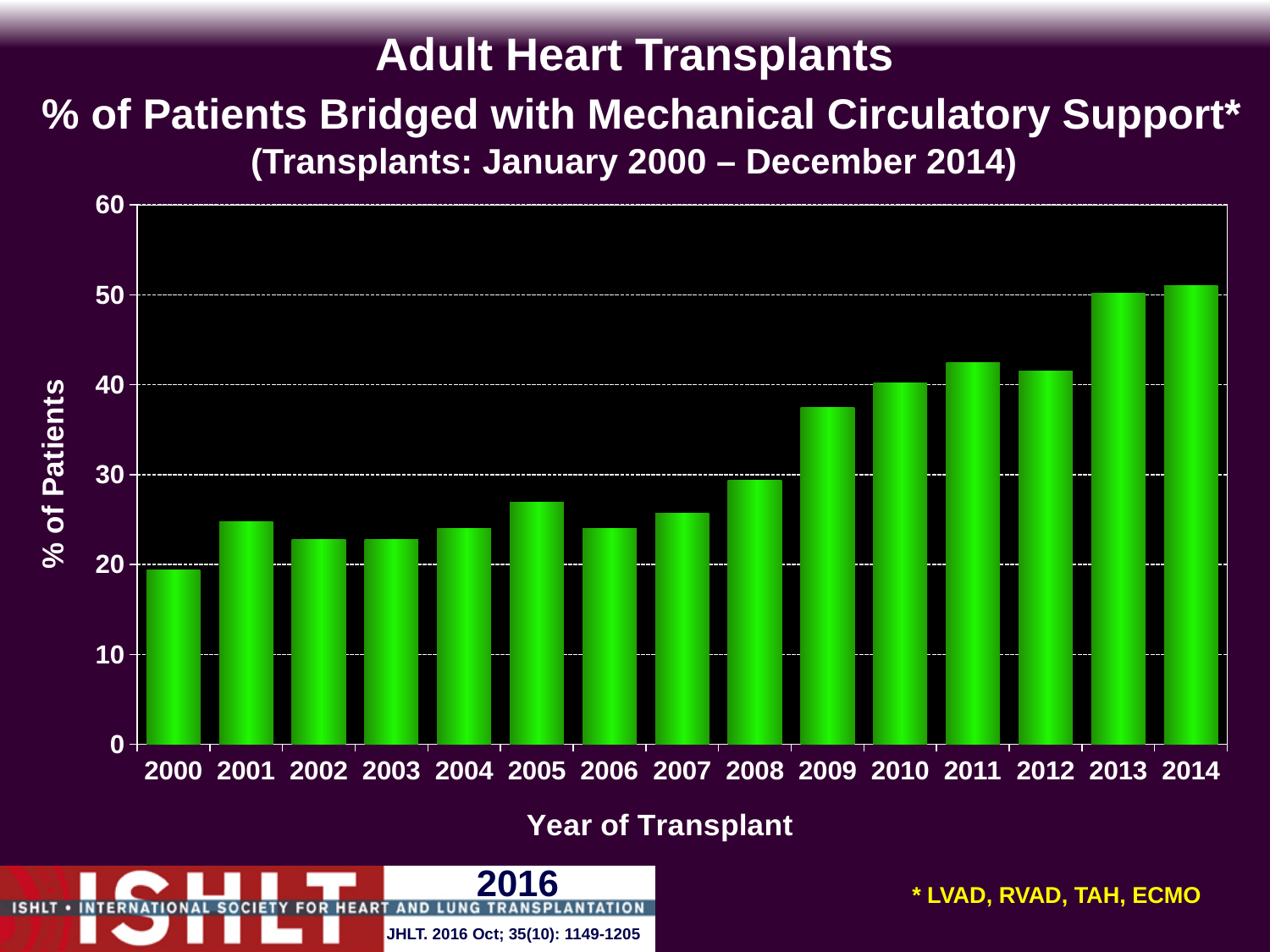
Is the value for 2005 greater or less than 20? greater What is the label of the x axis? Year of Transplant Which year has the lowest % of patients bridged with mechanical circulatory support? 2000 Which year has the larger value, 2010 or 2013? 2013 Which year has the larger value, 2008 or 2009? 2009 Is the value for 2013 greater or less than 40? greater How many years of transplant are shown on the x axis? 15 What kind of chart is shown on the slide? bar chart Overall, do the values rise or fall from 2000 to 2014? rise Is the value for 2002 greater or less than 30? less What is the label of the y axis? % of Patients